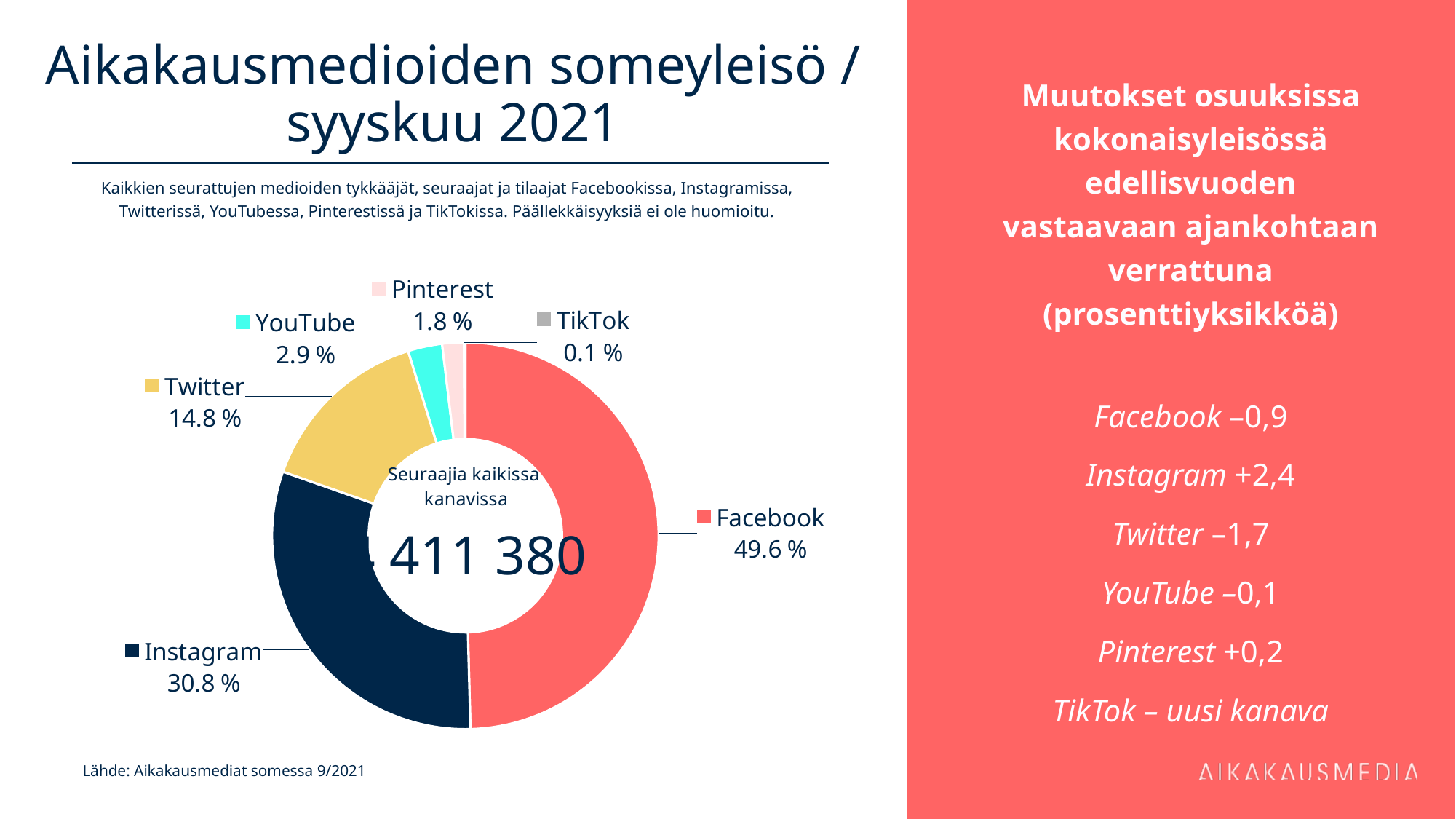
What percentage is shown for Instagram in the donut chart? 30.8 % What colour is the Twitter slice in the donut chart? Yellow What is the value shown for Twitter in the chart? 14.8 % Which channel has the largest share in the donut chart? Facebook How many channels (slices) are shown in the donut chart? 6 Which channel has the smallest share in the donut chart? TikTok What type of chart is used on the slide? Donut (pie) chart What share of the donut chart does Facebook account for? 49.6 % What percentage does the chart show for TikTok? 0.1 % Which has a larger share, YouTube or Pinterest? YouTube What is the difference in percentage points between Facebook's and Instagram's shares? 18.8 What is the combined share of Twitter and YouTube? 17.7 %